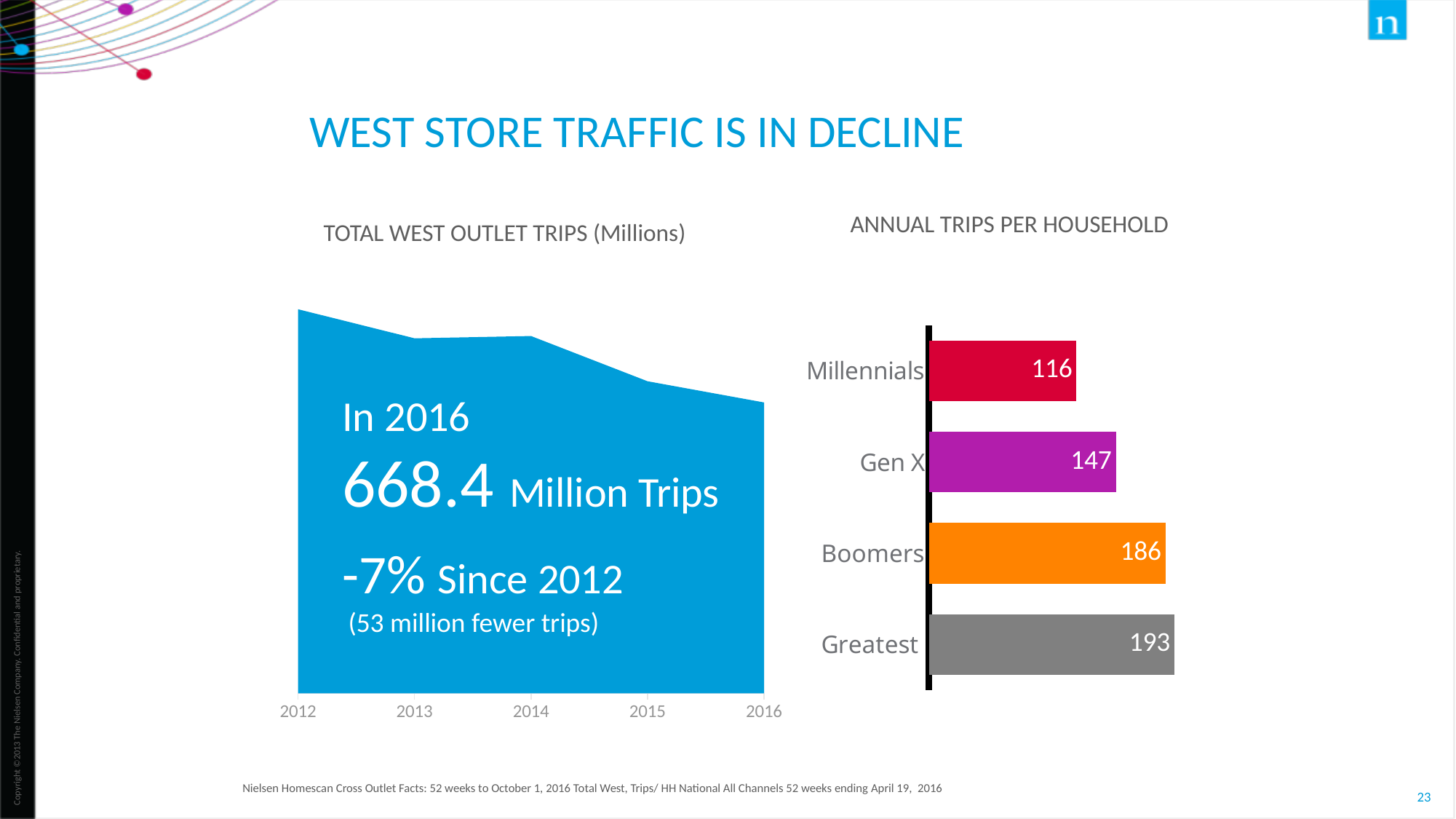
In the ANNUAL TRIPS PER HOUSEHOLD chart, which group has the lowest annual trips per household? Millennials In the TOTAL WEST OUTLET TRIPS (Millions) chart, do the values rise or fall from 2012 to 2016? Fall How many groups are shown in the ANNUAL TRIPS PER HOUSEHOLD chart? 4 How many years are shown on the x axis of the TOTAL WEST OUTLET TRIPS (Millions) chart? 5 What kind of chart is the ANNUAL TRIPS PER HOUSEHOLD chart? Bar chart In the ANNUAL TRIPS PER HOUSEHOLD chart, what is the value for Millennials? 116 In the ANNUAL TRIPS PER HOUSEHOLD chart, which is larger, Gen X or Boomers? Boomers In the ANNUAL TRIPS PER HOUSEHOLD chart, what is the difference between the Greatest and Millennials values? 77 According to the TOTAL WEST OUTLET TRIPS (Millions) chart, how many million trips were there in 2016? 668.4 In the ANNUAL TRIPS PER HOUSEHOLD chart, which group has the highest annual trips per household? Greatest In the ANNUAL TRIPS PER HOUSEHOLD chart, what is the value for Gen X? 147 In the ANNUAL TRIPS PER HOUSEHOLD chart, what is the value for Boomers? 186